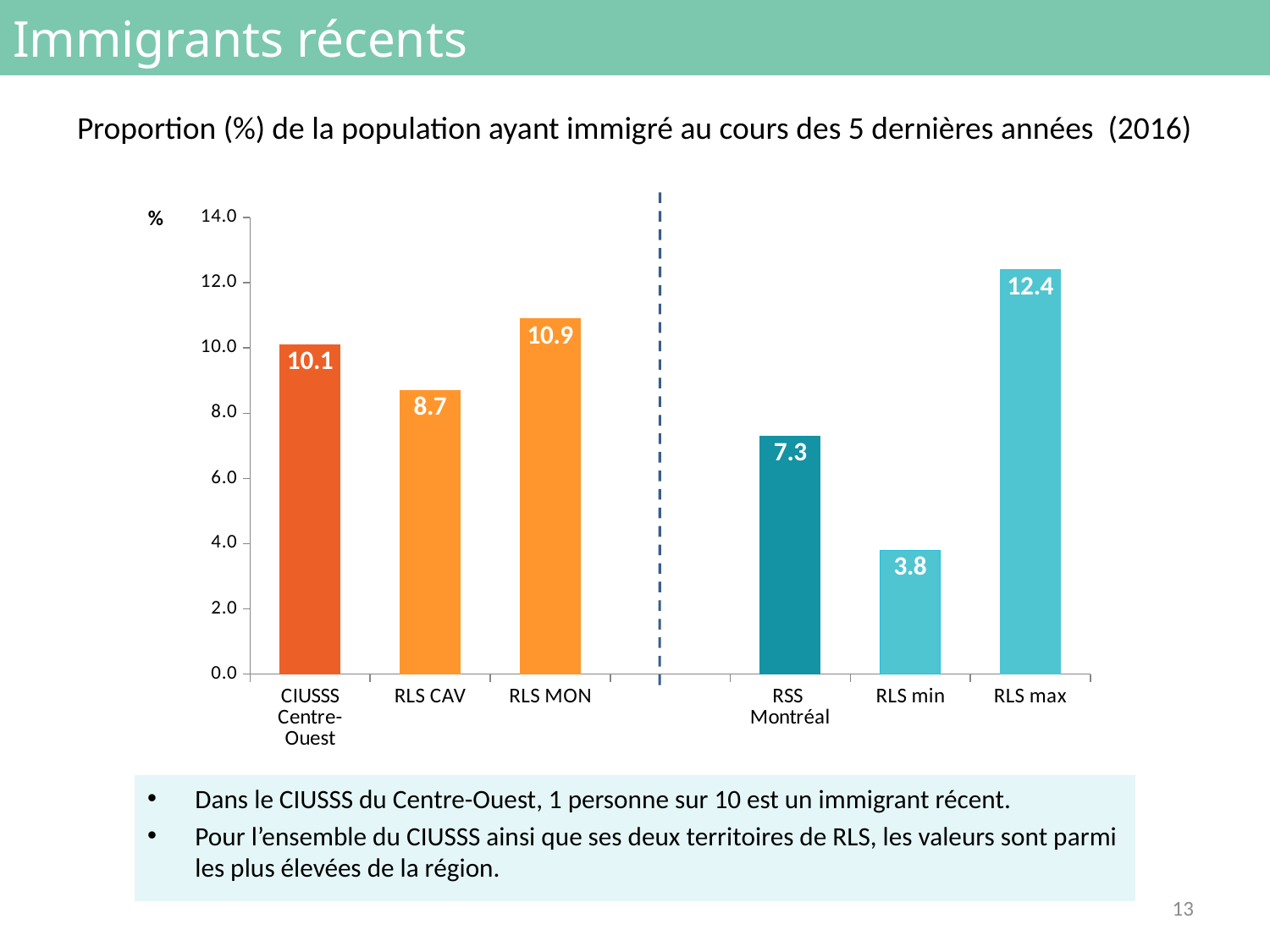
What is the value for RLS MON? 10.9 What is the difference between the values for CIUSSS Centre-Ouest and RSS Montréal? 2.8 Which is larger, the value for RLS MON or the value for RLS CAV? RLS MON Which category has the highest value? RLS max How many bars are shown in the chart? 6 What is the value for CIUSSS Centre-Ouest? 10.1 What is the title of the chart? Proportion (%) de la population ayant immigré au cours des 5 dernières années (2016) What is the value for RSS Montréal? 7.3 What is the value for RLS CAV? 8.7 Which category has the lowest value? RLS min What kind of chart is shown on the slide? Bar chart What is the difference between the values for RLS max and RLS min? 8.6